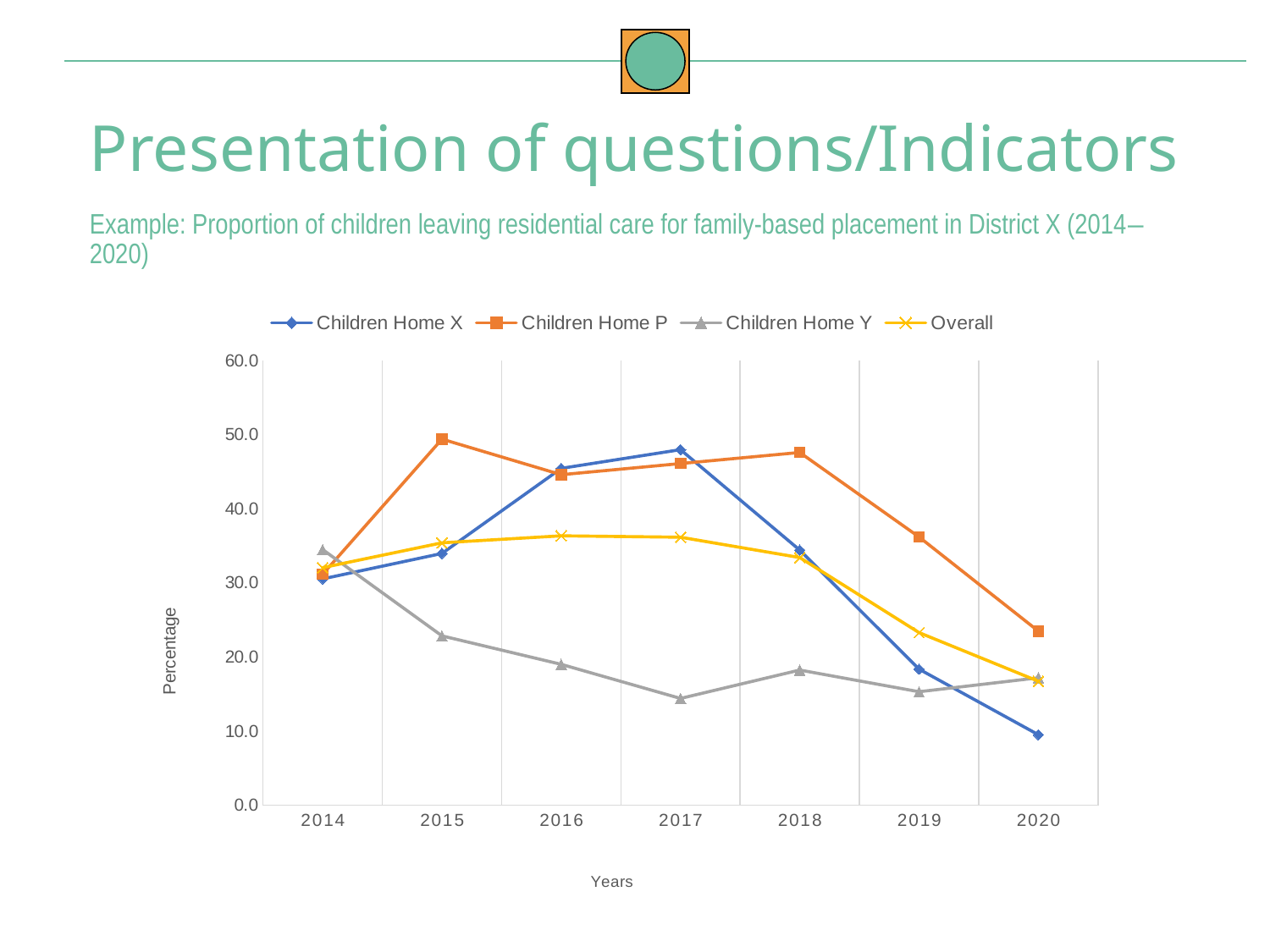
Is the value for Children Home Y in 2017 greater or less than 20.0? less What kind of chart is shown on the slide? line chart Is the value for Children Home P in 2015 greater or less than 40.0? greater In which year does Children Home X reach its highest value? 2017 In 2014, which is larger: Children Home Y or Children Home X? Children Home Y Which series has the lowest value in 2020? Children Home X Which series has the highest value in 2018? Children Home P In 2020, which is larger: Children Home P or Children Home X? Children Home P How many series does the legend list? 4 Is the value for Children Home X in 2020 greater or less than 20.0? less Does the Children Home Y line rise or fall from 2014 to 2017? fall How many years are plotted along the x axis? 7